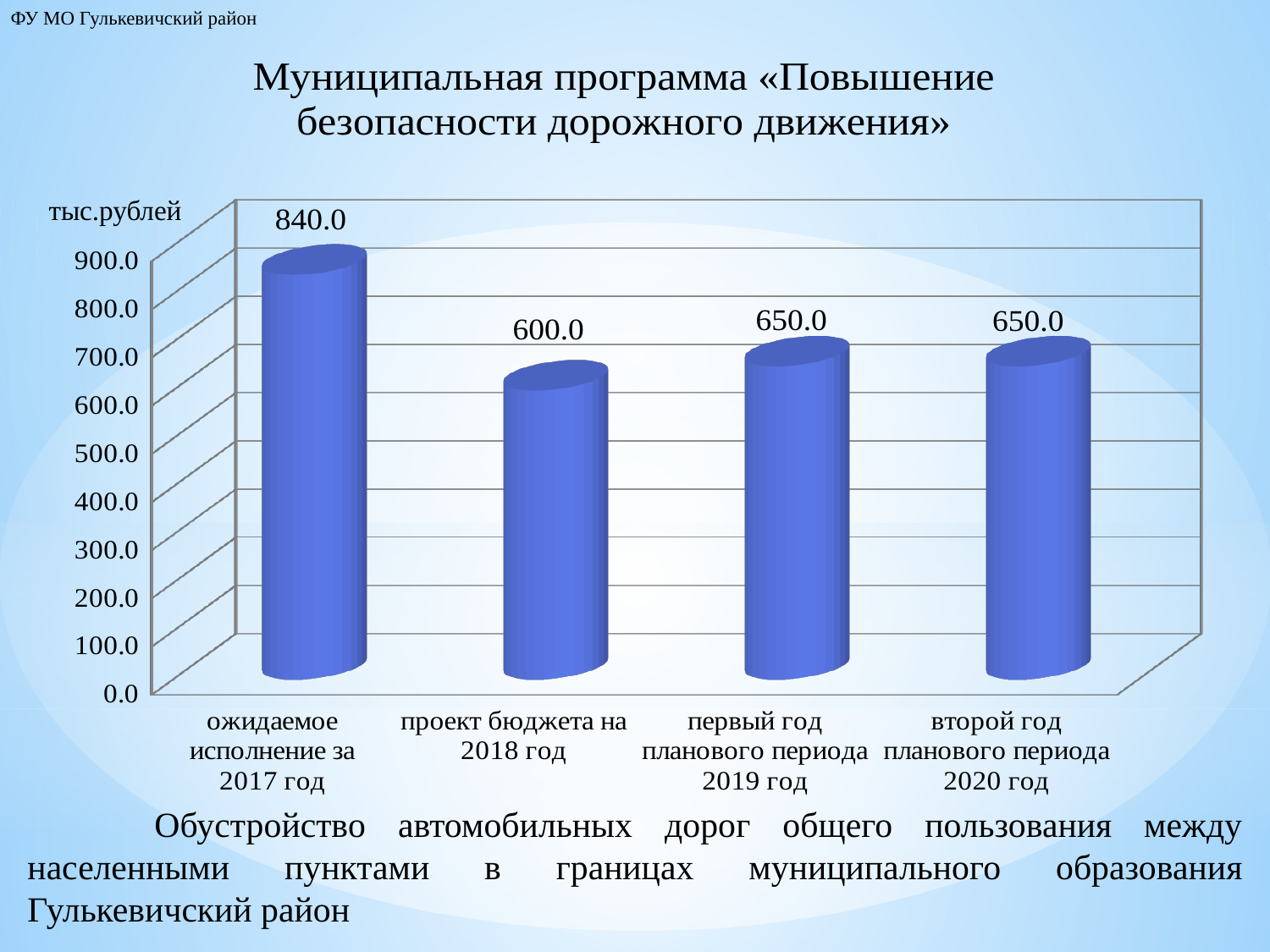
Which category has the lowest value? проект бюджета на 2018 год What is the difference between the value for 2019 and the value for 2018? 50.0 What is the value for 'ожидаемое исполнение за 2017 год'? 840.0 What kind of chart is shown on the slide? bar chart What is the value for 'второй год планового периода 2020 год'? 650.0 What is the value for 'первый год планового периода 2019 год'? 650.0 Which category has the highest value? ожидаемое исполнение за 2017 год How many categories are shown on the x axis? 4 What is the difference between the value for 2017 and the value for 2018? 240.0 What unit is indicated above the vertical axis? тыс.рублей What is the value for 'проект бюджета на 2018 год'? 600.0 Which is larger: the value for 2017 or the value for 2019? 2017